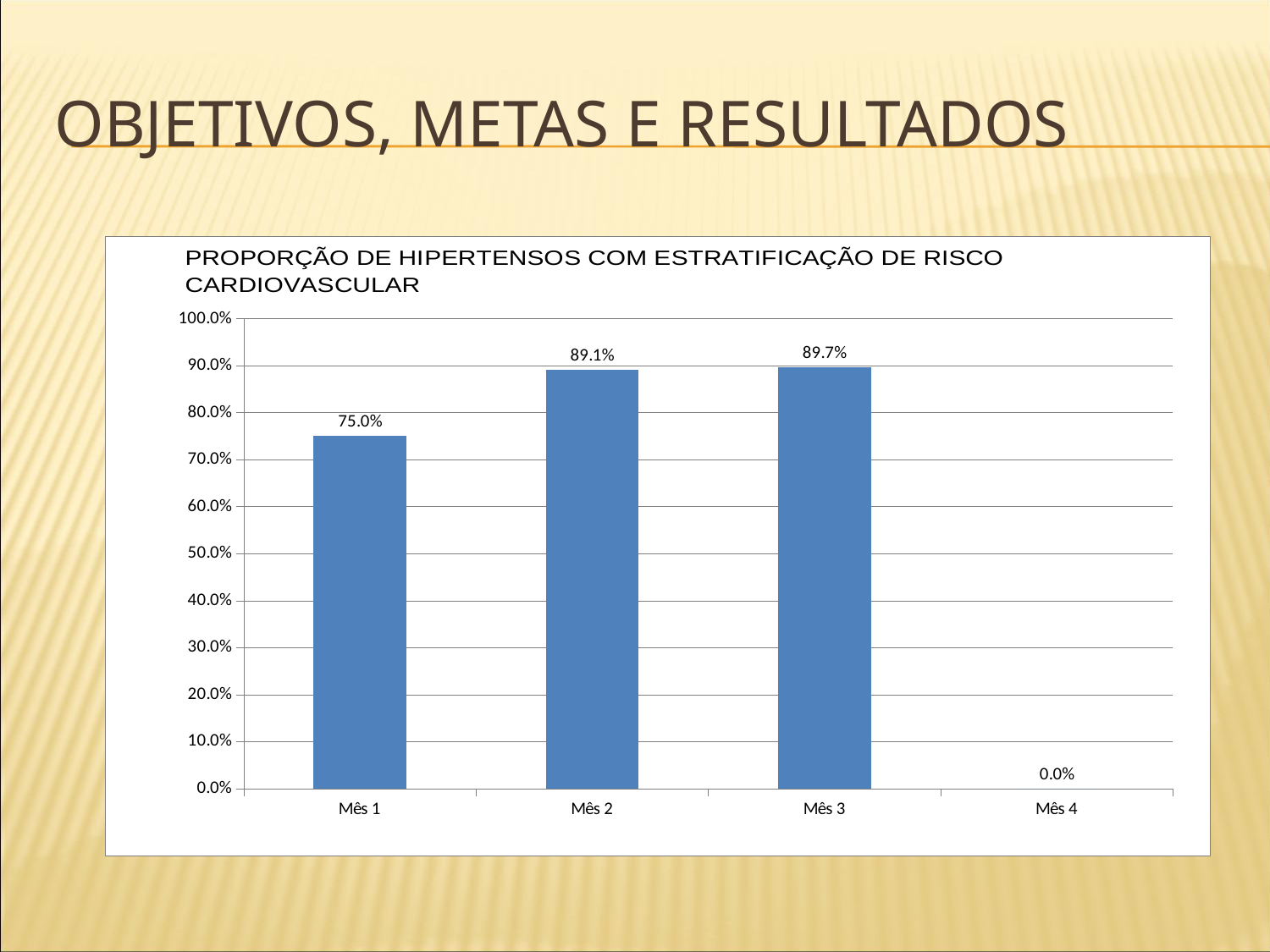
What kind of chart is shown on the slide? bar chart What is the value for Mês 1? 75.0% How many months are shown on the x axis? 4 What is the value for Mês 4? 0.0% Which month has the highest value? Mês 3 What is the value for Mês 2? 89.1% Which is larger, the value for Mês 1 or the value for Mês 2? Mês 2 What is the title of the chart? PROPORÇÃO DE HIPERTENSOS COM ESTRATIFICAÇÃO DE RISCO CARDIOVASCULAR Is the value for Mês 1 greater or less than 80.0%? less What is the difference between the values for Mês 2 and Mês 1? 14.1% Which month has the lowest value? Mês 4 What is the value for Mês 3? 89.7%